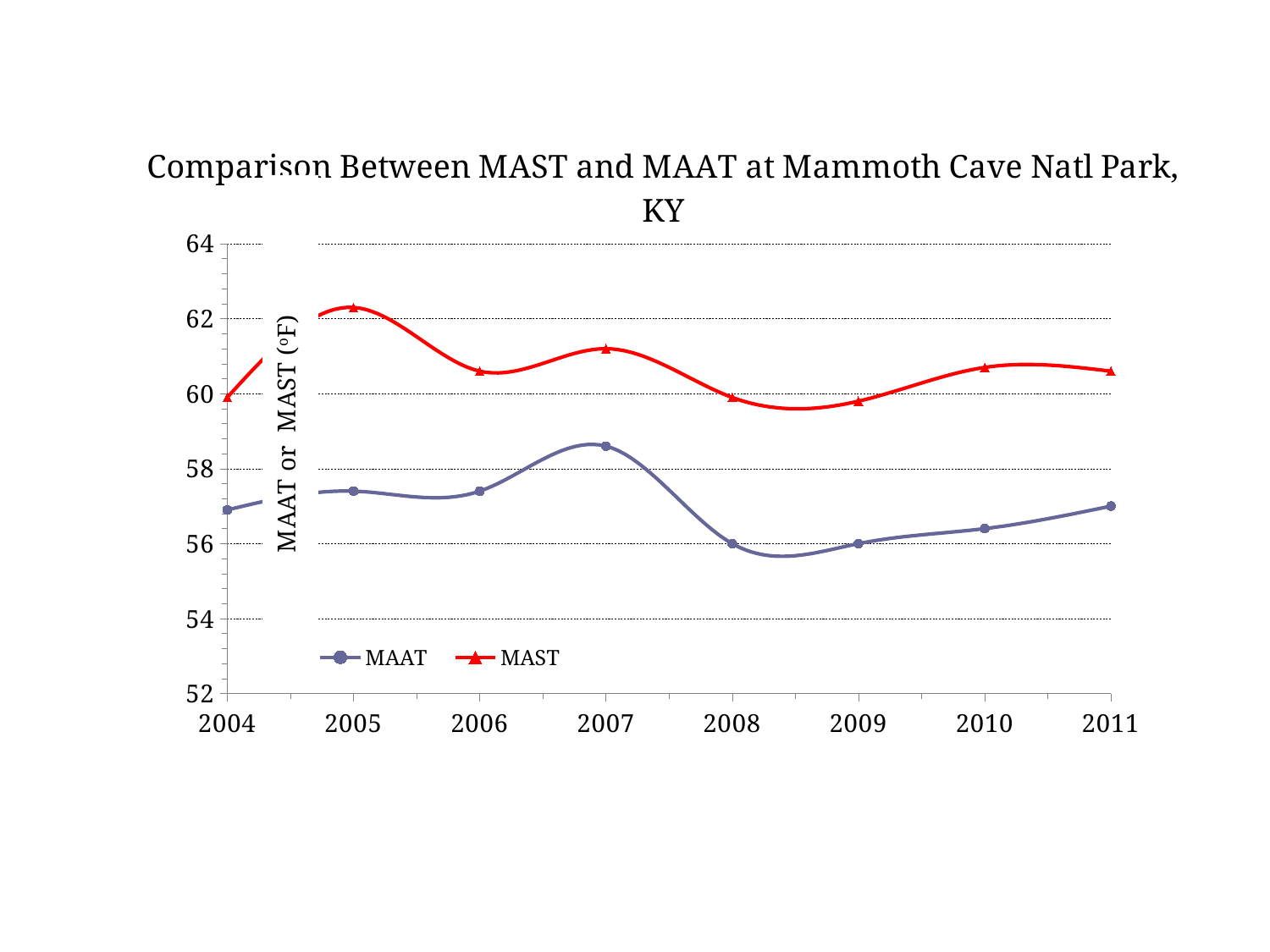
In which year is the MAST value highest? 2005 How many series does the legend list? 2 Is the MAST value for 2005 greater or less than 62? greater Is the MAST value for 2010 greater or less than 60? greater What kind of chart is shown on the slide? line chart What is the label on the y axis? MAAT or MAST (°F) Is the MAAT value for 2004 greater or less than 58? less Does the MAAT line rise or fall from 2009 to 2011? rise How many years are plotted along the x axis? 8 In which year is the MAAT value highest? 2007 Which is larger in 2007, MAST or MAAT? MAST